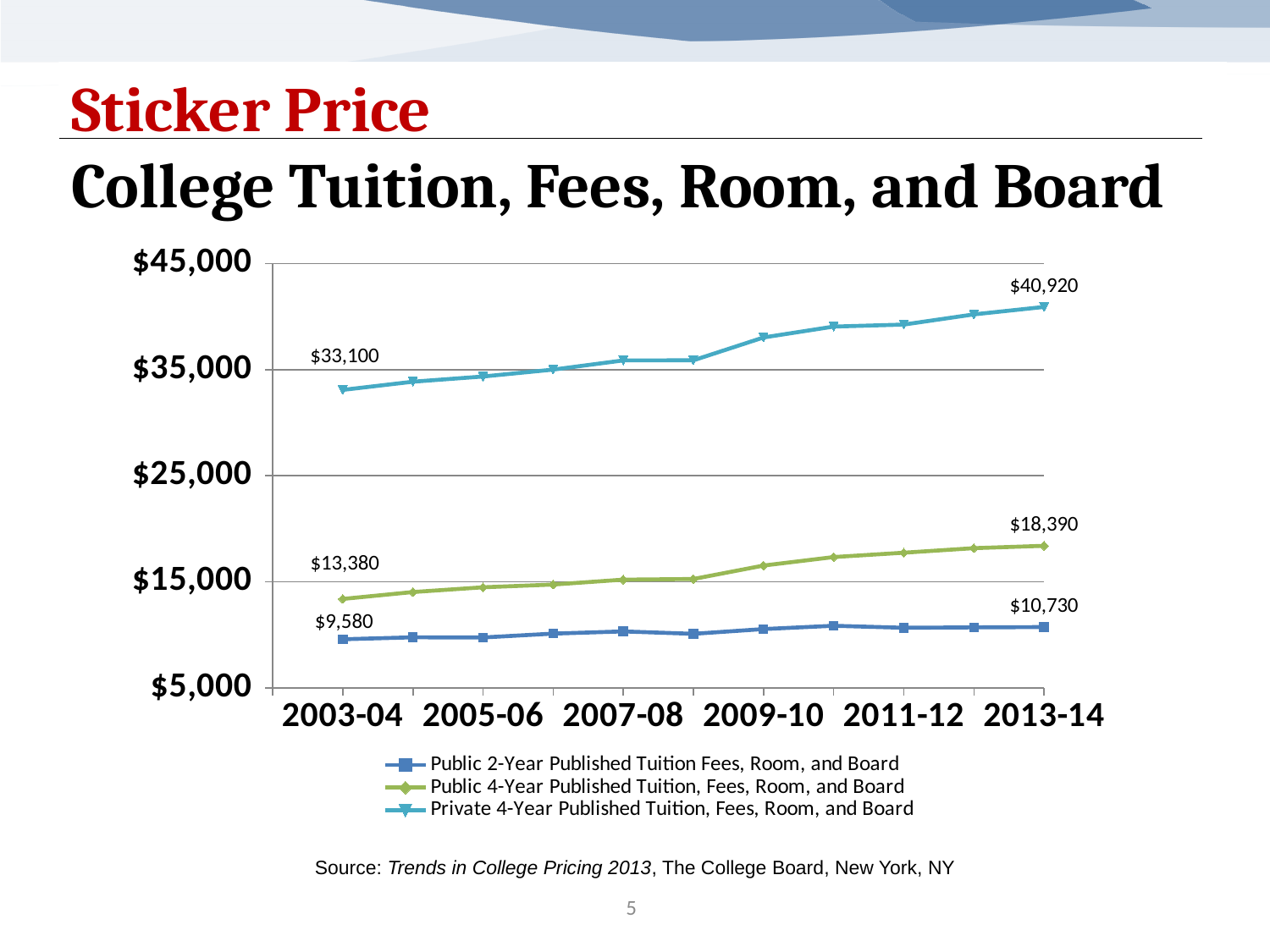
Which series has the lowest values across the chart? Public 2-Year Published Tuition Fees, Room, and Board What is the value for Public 4-Year Published Tuition, Fees, Room, and Board in 2013-14? $18,390 How many series does the legend list? 3 What is the value for Private 4-Year Published Tuition, Fees, Room, and Board in 2003-04? $33,100 By how much did Public 4-Year Published Tuition, Fees, Room, and Board increase from 2003-04 ($13,380) to 2013-14 ($18,390)? $5,010 Is the value for Public 4-Year Published Tuition, Fees, Room, and Board in 2009-10 greater or less than $15,000? greater What is the value for Private 4-Year Published Tuition, Fees, Room, and Board in 2013-14? $40,920 What type of chart is shown on the slide? line chart By how much did Private 4-Year Published Tuition, Fees, Room, and Board increase from 2003-04 to 2013-14? $7,820 What is the value for Public 2-Year Published Tuition Fees, Room, and Board in 2003-04? $9,580 Does the Private 4-Year Published Tuition, Fees, Room, and Board series rise or fall from 2003-04 to 2013-14? rise Which series has the highest values across the chart? Private 4-Year Published Tuition, Fees, Room, and Board